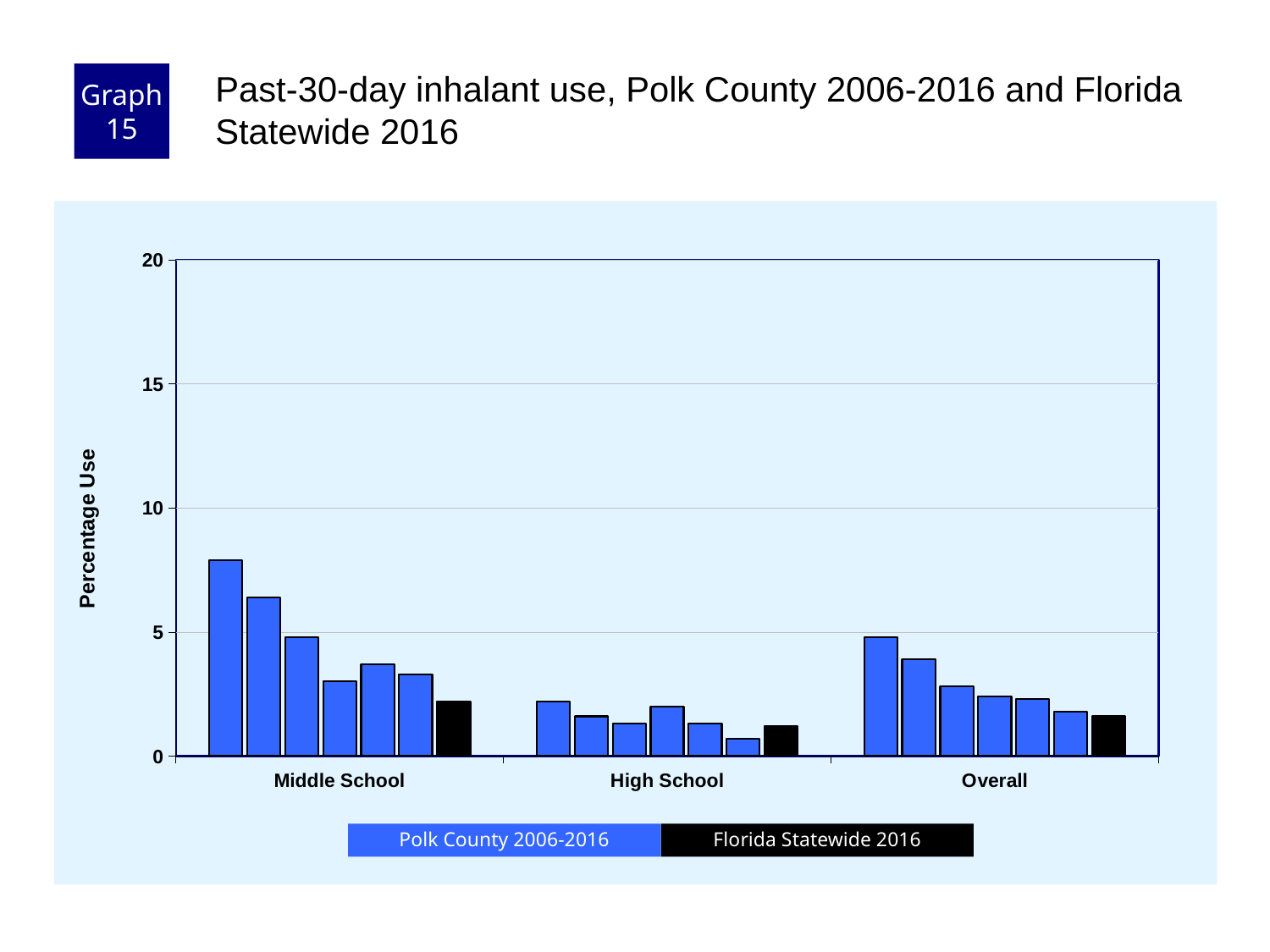
Which group has the lowest Florida Statewide 2016 bar? High School Which group has the highest Florida Statewide 2016 bar? Middle School How many series does the legend list? 2 Is the value for the first (leftmost) Polk County bar in the Middle School group greater or less than 5? greater Is the value for the Florida Statewide 2016 bar in the High School group greater or less than 5? less What kind of chart is shown on the slide? bar chart Which colour represents Florida Statewide 2016 in the legend? black Is the value for the first (leftmost) Polk County bar in the Overall group greater or less than 10? less How many school-level categories are shown on the x axis? 3 Which is larger: the leftmost Polk County bar in the Middle School group or the leftmost Polk County bar in the High School group? Middle School Do the Polk County 2006-2016 bars in the Middle School group generally rise or fall from left to right? fall What is the label on the y axis? Percentage Use